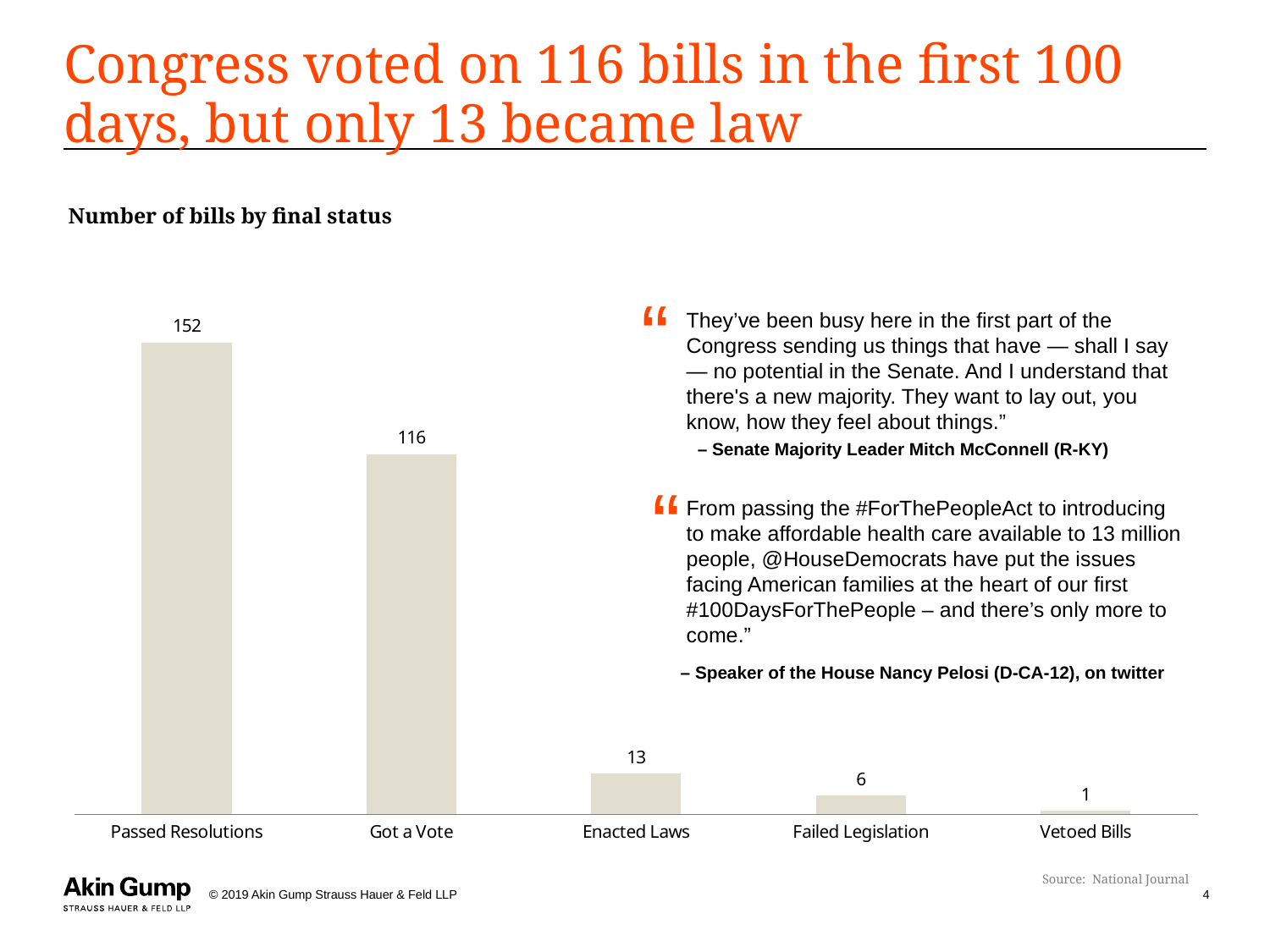
What is the number of bills for Passed Resolutions? 152 What kind of chart is shown on the slide? Bar chart What is the difference between the number of bills for Passed Resolutions and Got a Vote? 36 Which category has the highest number of bills? Passed Resolutions What is the number of bills for Enacted Laws? 13 What is the number of bills for Failed Legislation? 6 What is the difference between the number of bills for Enacted Laws and Failed Legislation? 7 What is the number of bills for Vetoed Bills? 1 Which is larger, the number of bills for Enacted Laws or for Failed Legislation? Enacted Laws Which category has the lowest number of bills? Vetoed Bills How many categories are shown in the chart? 5 What is the number of bills for Got a Vote? 116